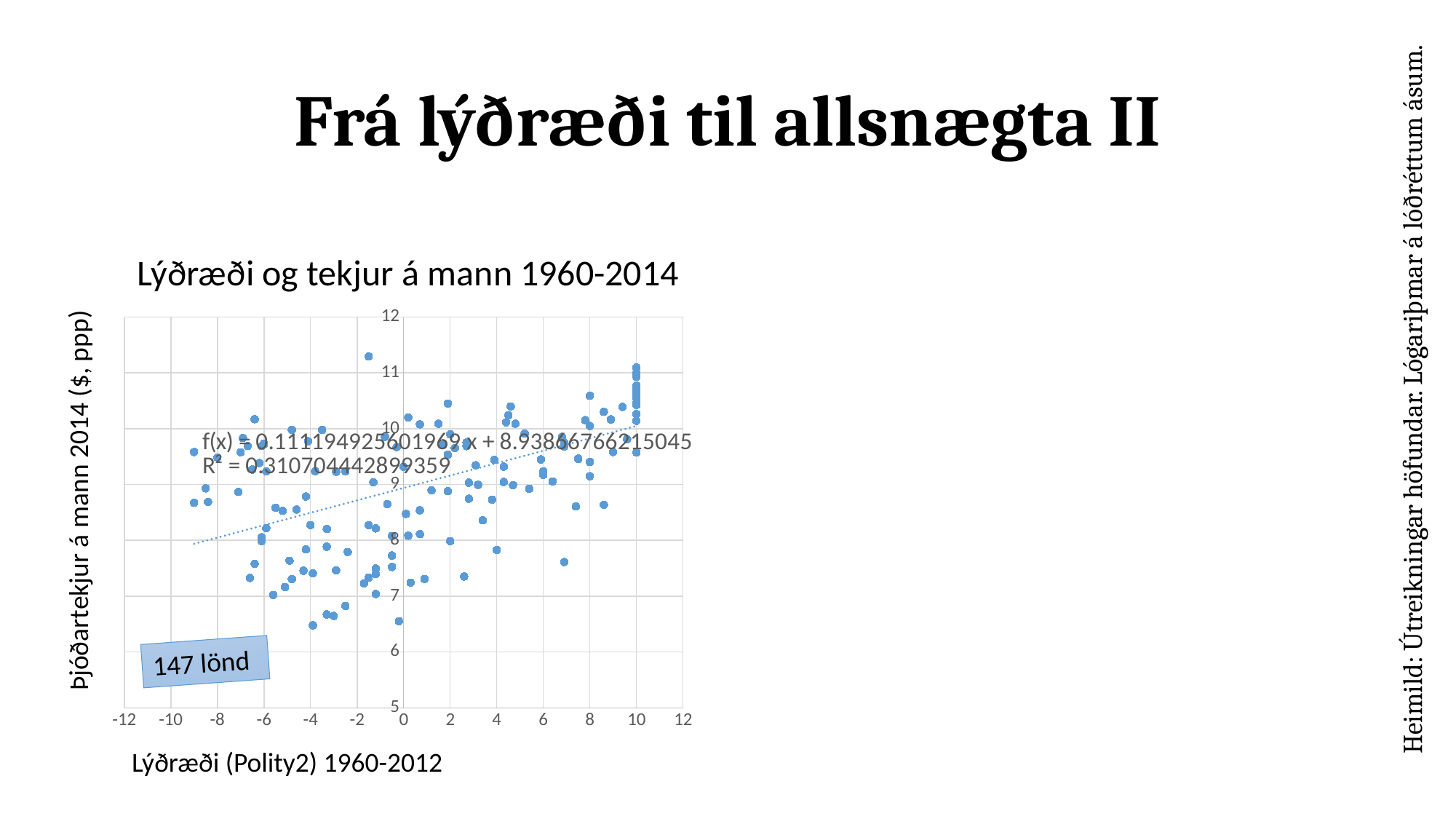
How many countries does the chart annotation say are plotted? 147 lönd What R² value is printed on the chart? 0.310704442899359 What is the highest tick value shown on the vertical axis? 12 Is the y value of the lowest plotted point greater or less than 7? less What is the lowest tick value shown on the horizontal axis? -12 What is the lowest tick value shown on the vertical axis? 5 What kind of chart is shown on the slide? Scatter chart Is the trendline's value at x = 10 greater or less than 9? greater Is the y value of the highest plotted point greater or less than 11? greater What is the title of the chart? Lýðræði og tekjur á mann 1960-2014 What is the label of the horizontal axis of the chart? Lýðræði (Polity2) 1960-2012 Does the fitted trendline rise or fall as the Polity2 score increases along the x axis? Rises